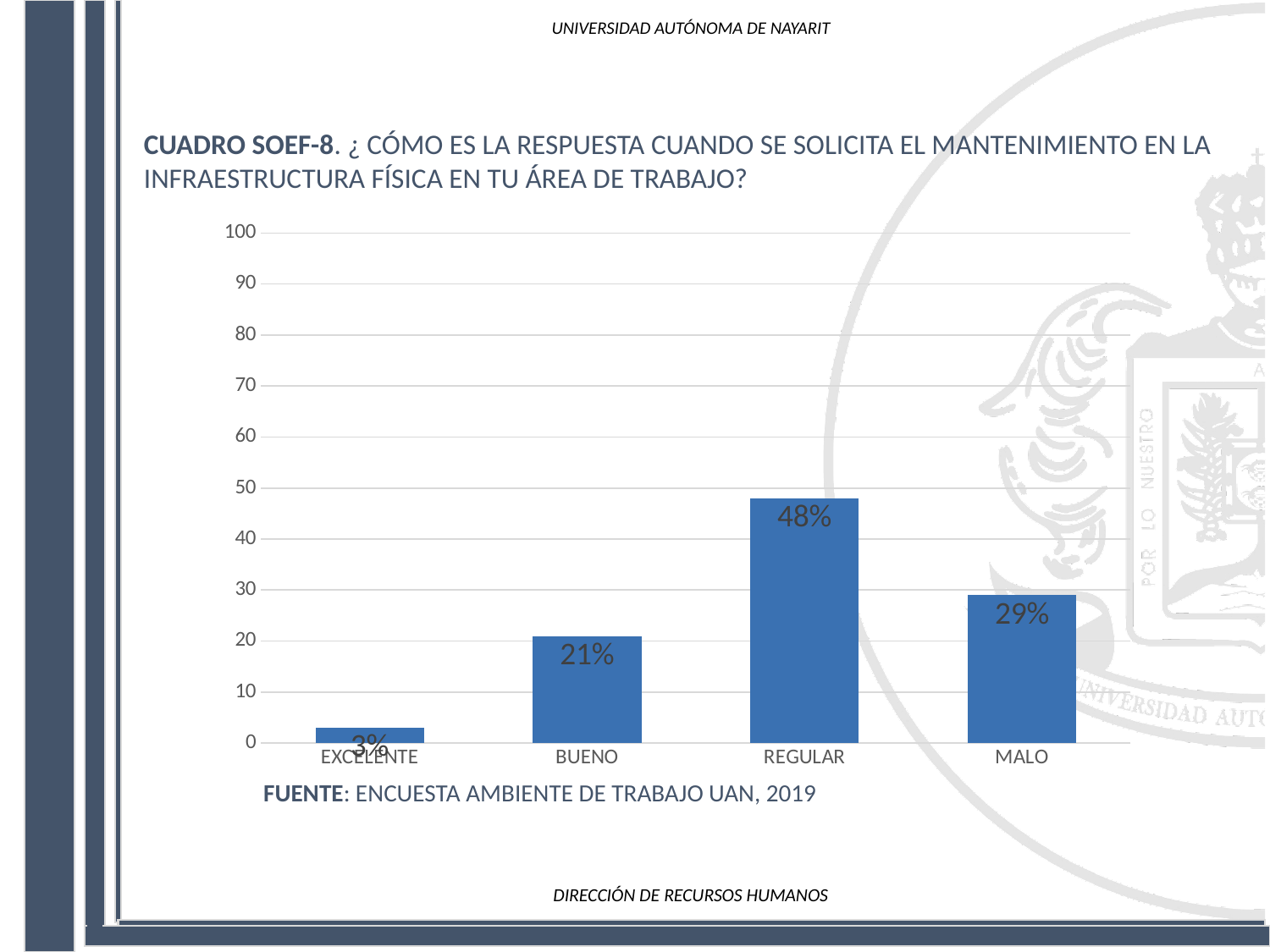
Is the value for REGULAR greater or less than 40? greater What is the value for EXCELENTE? 3% Which is larger, the value for BUENO or the value for MALO? MALO What kind of chart is shown on the slide? bar chart Which category has the lowest value? EXCELENTE How many categories are shown on the x axis? 4 What is the value for REGULAR? 48% What is the difference between the values for REGULAR and MALO? 19% What is the value for BUENO? 21% What is the value for MALO? 29% What source is cited below the chart? ENCUESTA AMBIENTE DE TRABAJO UAN, 2019 Which category has the highest value? REGULAR